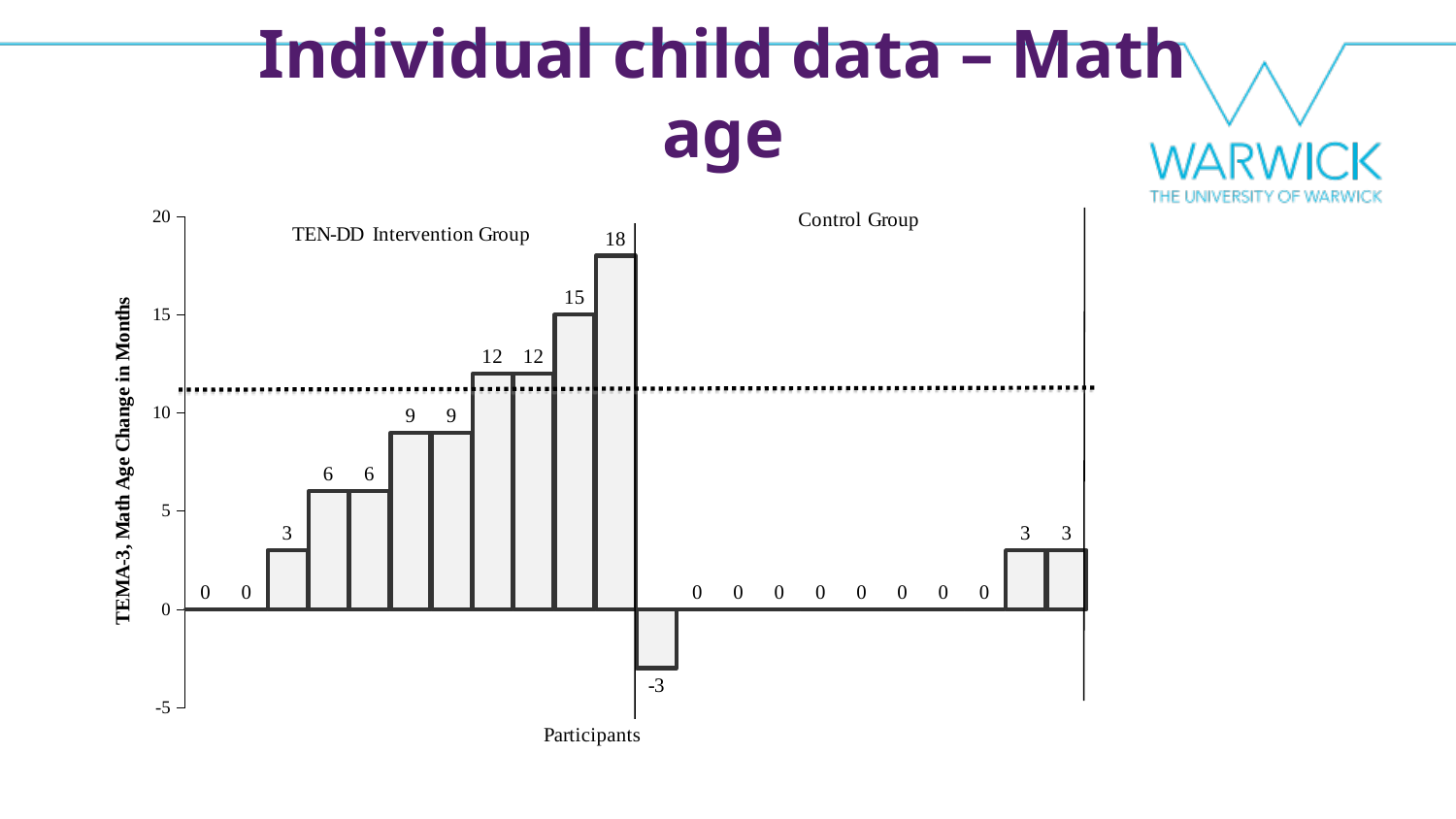
What is the difference between the highest value in the TEN-DD Intervention Group and the highest value in the Control Group? 15 What is the highest value shown in the Control Group? 3 Which group contains the participant with the largest math age change, the TEN-DD Intervention Group or the Control Group? TEN-DD Intervention Group How many participants are plotted in total across both groups? 22 How many participants are plotted in the TEN-DD Intervention Group? 11 What is the lowest value shown in the Control Group? -3 What kind of chart is shown on the slide? bar chart How many participants in the Control Group have a value of 0? 8 What is the label of the y axis? TEMA-3, Math Age Change in Months Do the values in the TEN-DD Intervention Group rise or fall from left to right along the x axis? rise What is the highest value shown in the TEN-DD Intervention Group? 18